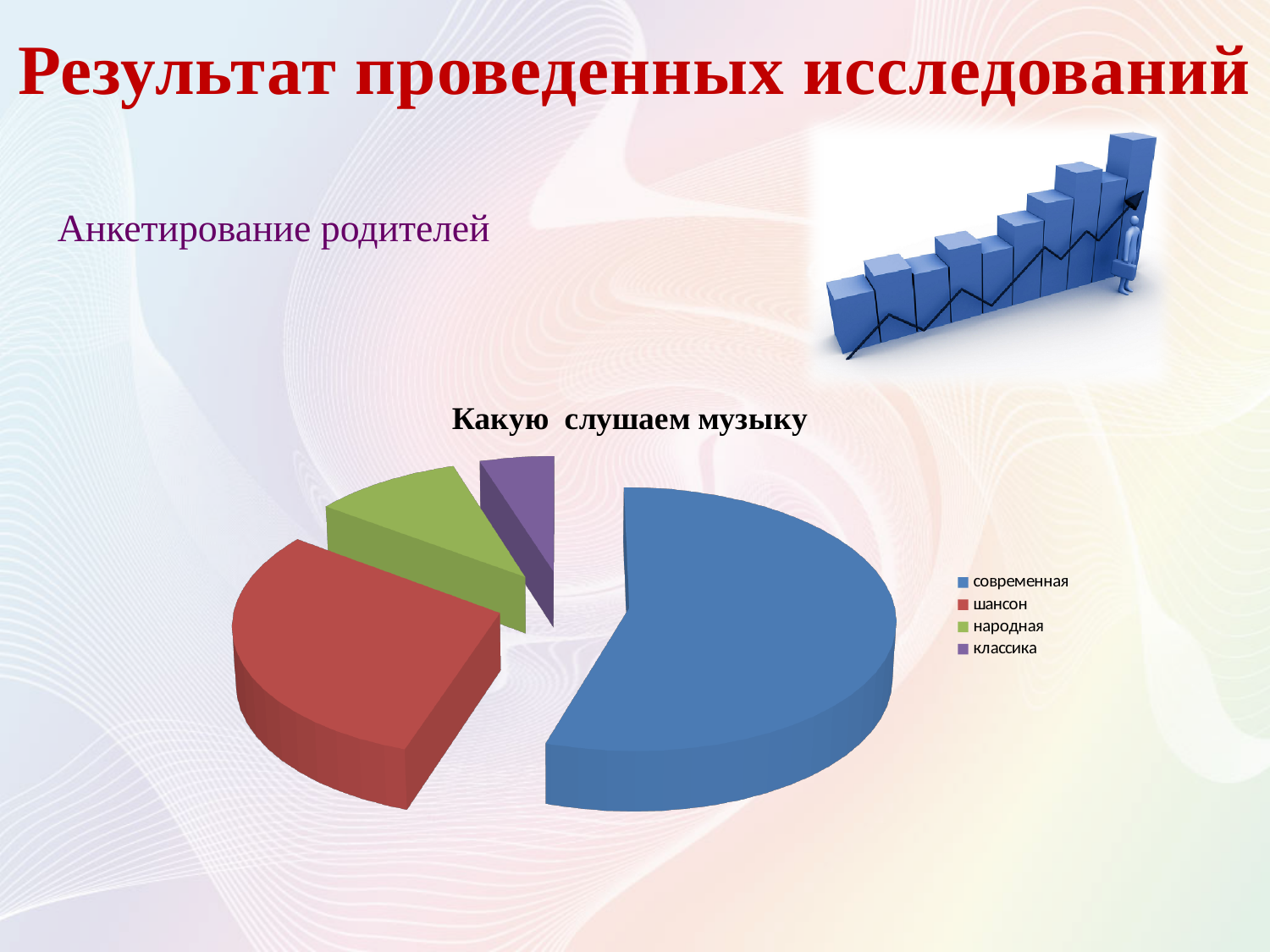
What is the title of the pie chart on the slide? Какую слушаем музыку Which slice is larger in the pie chart, народная or классика? народная Which colour represents шансон in the pie chart? red Which category has the smallest slice in the pie chart? классика How many categories (slices) does the pie chart have? 4 What kind of chart is shown under the title "Какую слушаем музыку"? pie chart Which category has the largest slice in the pie chart? современная Which slice is larger in the pie chart, современная or шансон? современная Which slice is larger in the pie chart, шансон or народная? шансон How many entries does the legend of the pie chart list? 4